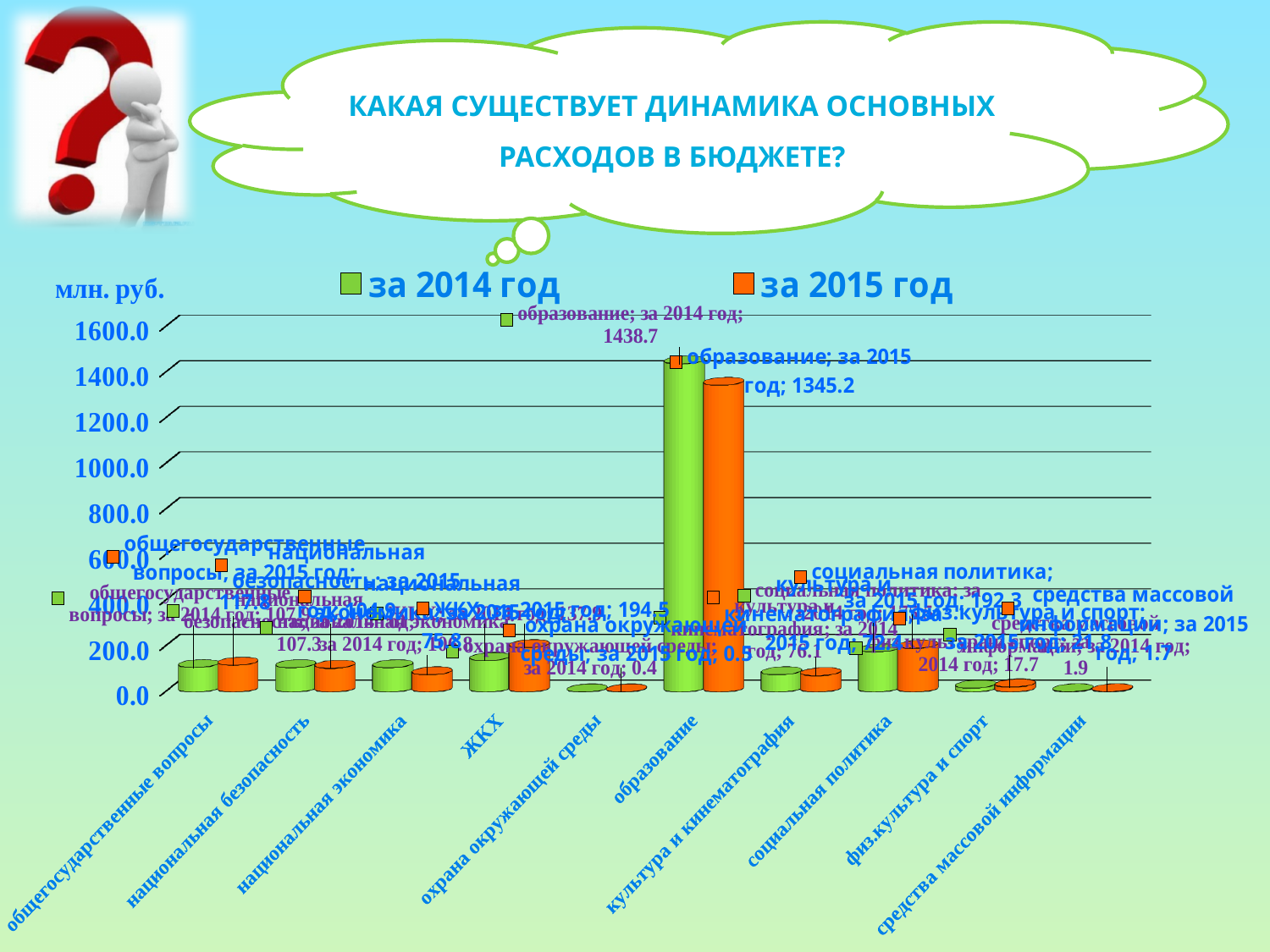
What is the value for образование for за 2015 год? 1345.2 Is the value for образование for за 2015 год greater or less than 1200? greater For образование, which is larger: the value for за 2014 год or for за 2015 год? за 2014 год What is the difference between the образование values for за 2014 год and за 2015 год? 93.5 Which category has the highest value for за 2014 год? образование How many expenditure categories are shown on the x axis? 10 What unit is shown on the vertical axis of the chart? млн. руб. Is the value for общегосударственные вопросы for за 2014 год greater or less than 200? less What is the value for образование for за 2014 год? 1438.7 What are the two legend entries of the chart? за 2014 год, за 2015 год How many series does the legend list? 2 What kind of chart is shown on the slide? bar chart